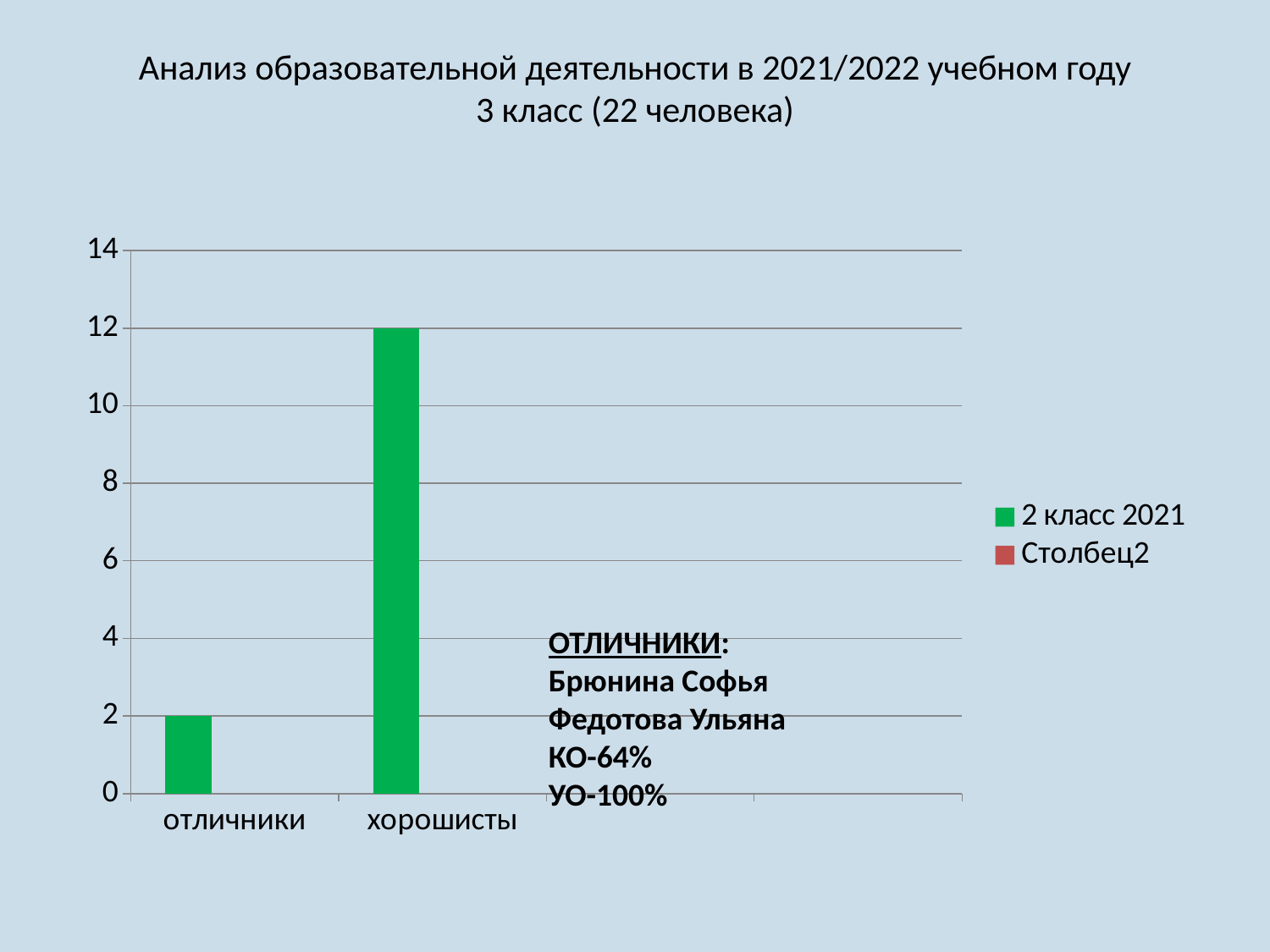
Which category has the lowest value? отличники What kind of chart is shown on the slide? bar chart Is the value for хорошисты greater or less than 10? greater Which category has the highest value? хорошисты What is the value for хорошисты? 12 How many series does the legend list? 2 How many labelled categories are shown on the x axis? 2 What is the first entry in the chart legend? 2 класс 2021 What is the difference between the values for хорошисты and отличники? 10 Is the value for отличники greater or less than 4? less Which is larger, the value for отличники or the value for хорошисты? хорошисты What is the value for отличники? 2